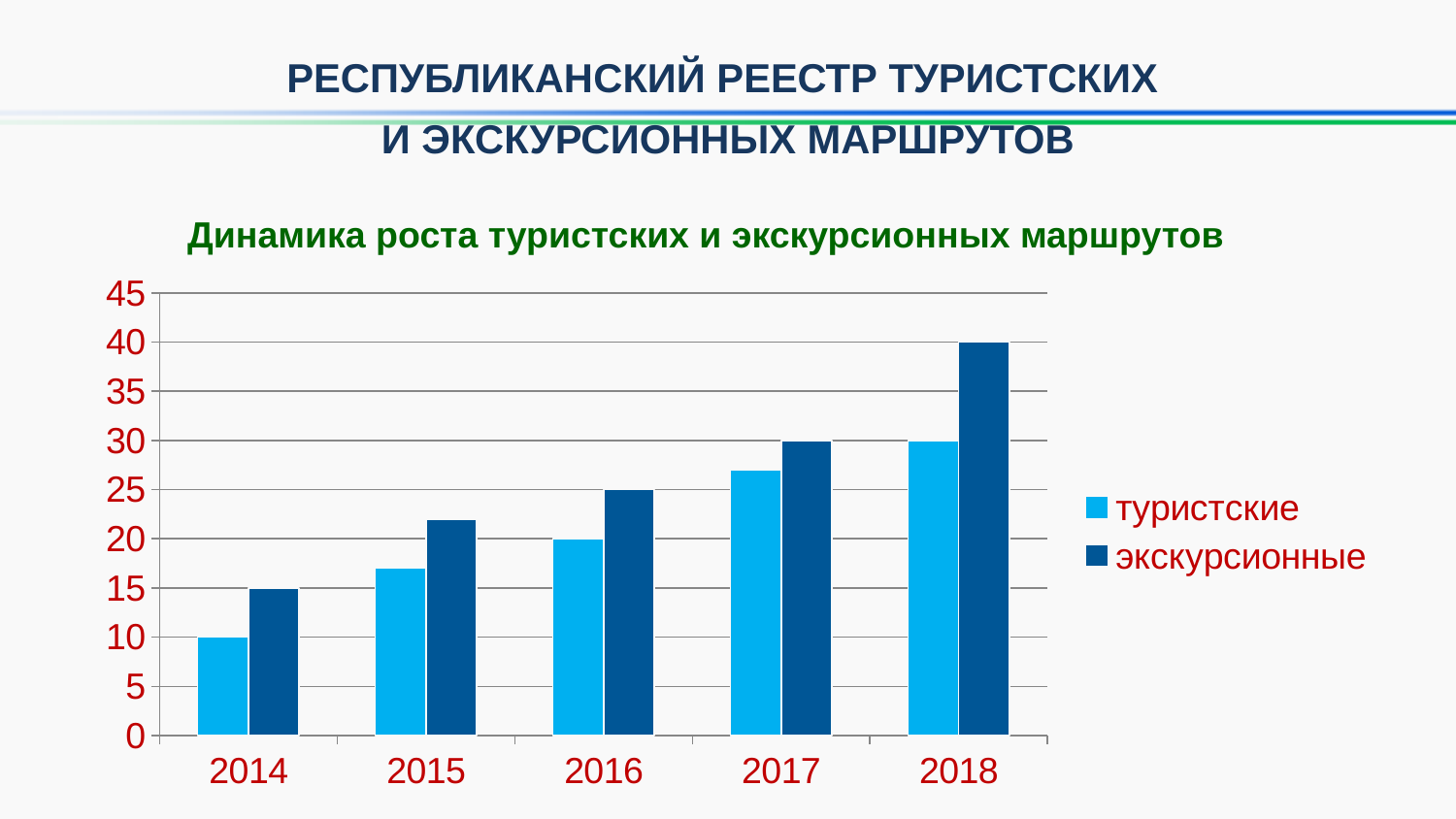
How many series does the legend list? 2 Do the values for туристские rise or fall from 2014 to 2018? rise How many years are shown on the x axis? 5 Which year has the lowest value for туристские? 2014 Is the value for туристские in 2015 greater or less than 15? greater What kind of chart is shown on the slide? bar chart Is the value for экскурсионные in 2017 greater or less than 35? less What is the value for туристские in 2018? 30 What is the value for экскурсионные in 2018? 40 What is the value for экскурсионные in 2014? 15 Which year has the highest value for экскурсионные? 2018 What is the value for туристские in 2014? 10